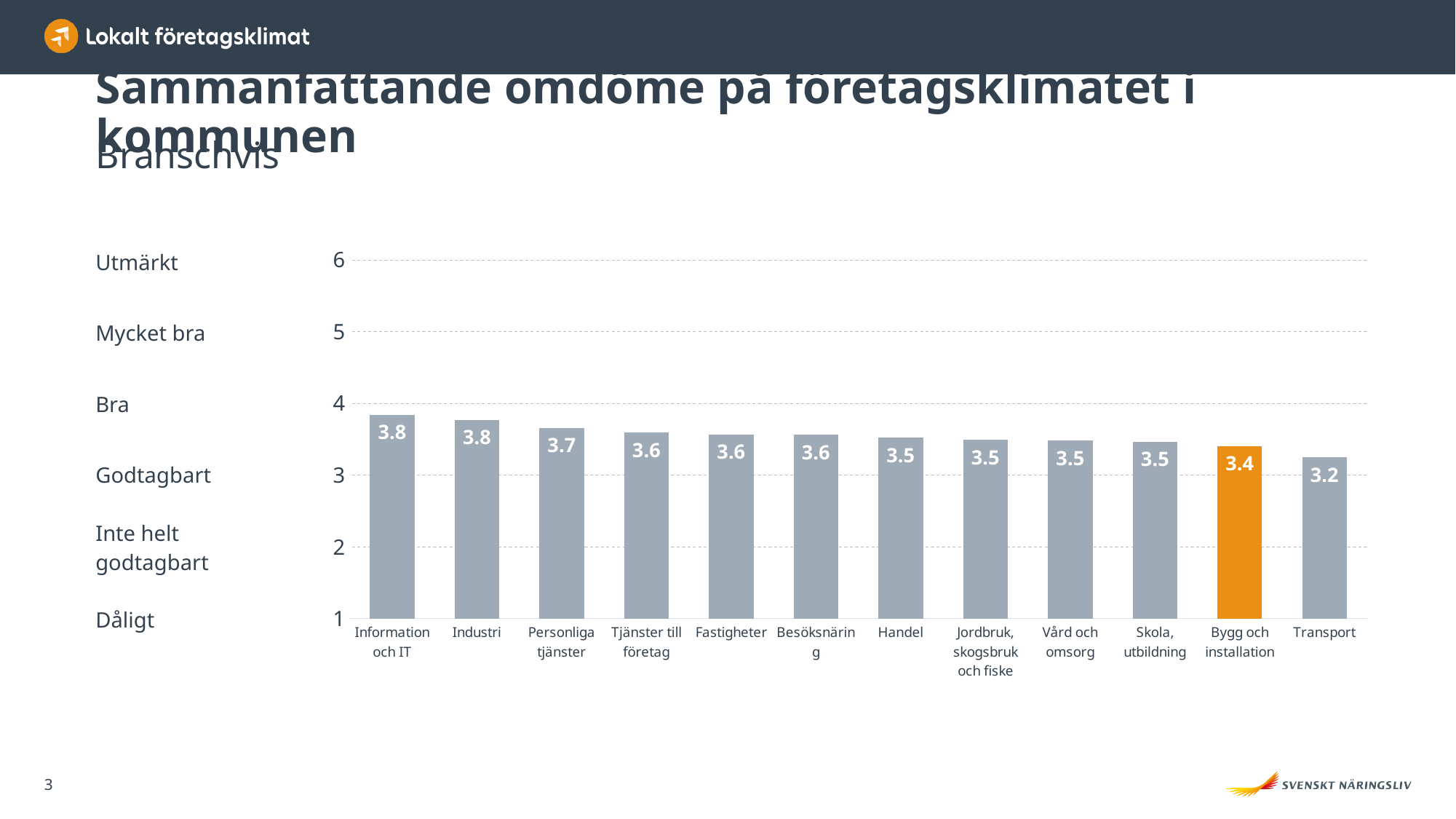
What is the value for Handel? 3.5 What kind of chart is shown on the slide? bar chart Which is larger, the value for Industri or the value for Bygg och installation? Industri How many categories are shown on the x axis? 12 Is the value for Transport greater or less than 4? less Do the values rise or fall from left to right along the x axis? fall Which category has the lowest value? Transport What is the value for Transport? 3.2 What is the difference between the values for Information och IT and Transport? 0.6 What is the value for Bygg och installation? 3.4 What is the value for Personliga tjänster? 3.7 Which category's bar is coloured orange? Bygg och installation